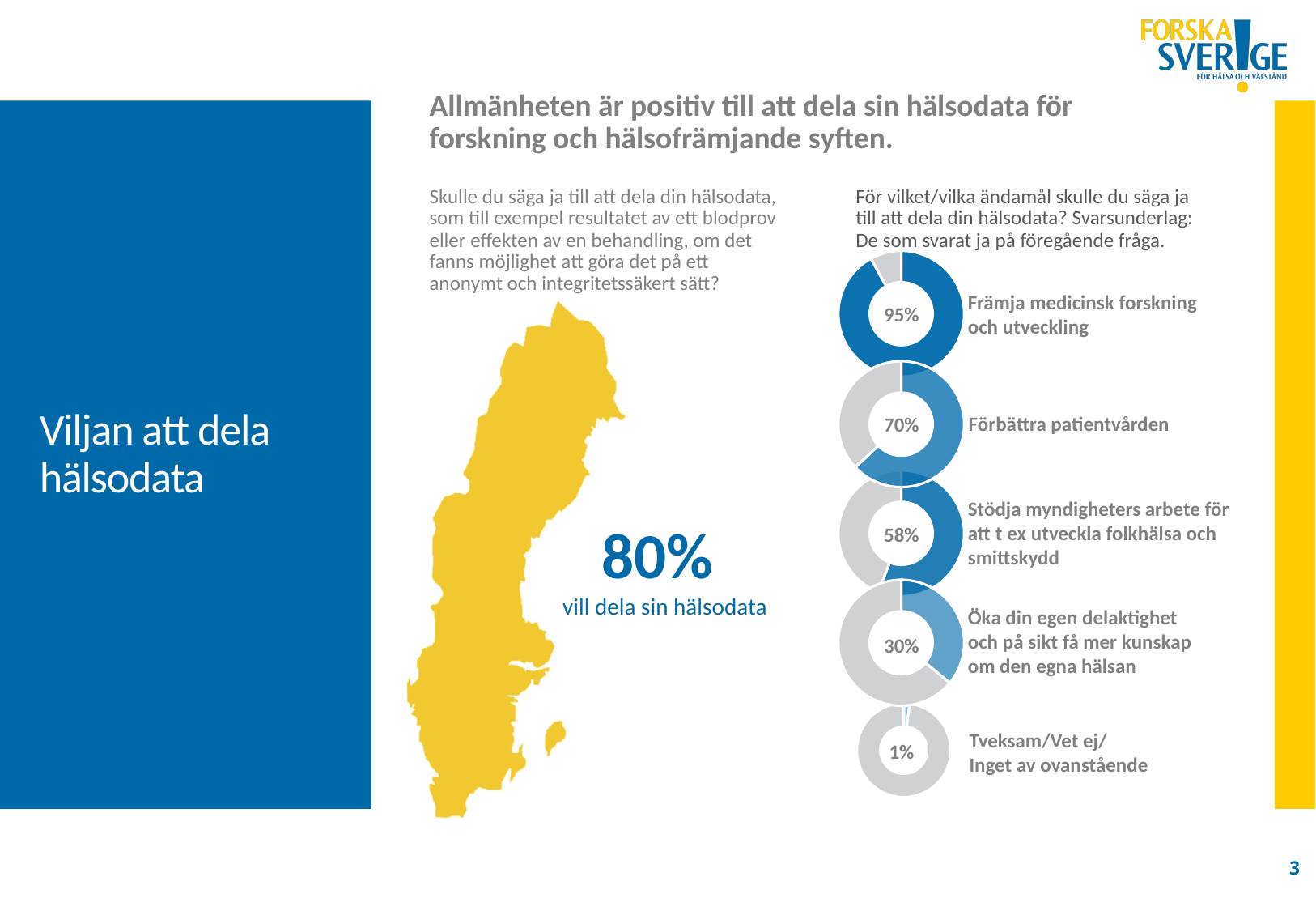
In the donut charts on the right, what percentage is shown for "Tveksam/Vet ej/Inget av ovanstående"? 1% According to the large figure next to the map of Sweden, what percentage want to share their health data? 80% In the donut charts on the right, what percentage is shown for "Förbättra patientvården"? 70% In the donut charts on the right, what percentage is shown for "Främja medicinsk forskning och utveckling"? 95% How many donut charts are shown on the right side of the slide? 5 In the donut charts on the right, what is the difference in percentage points between "Främja medicinsk forskning och utveckling" and "Förbättra patientvården"? 25 percentage points Among the donut charts on the right, which purpose has the highest percentage? Främja medicinsk forskning och utveckling What kind of chart is used to show the percentages on the right side of the slide? Donut chart In the donut charts on the right, what percentage is shown for "Stödja myndigheters arbete för att t ex utveckla folkhälsa och smittskydd"? 58% Among the donut charts on the right, which category has the lowest percentage? Tveksam/Vet ej/Inget av ovanstående In the donut charts on the right, what percentage is shown for "Öka din egen delaktighet och på sikt få mer kunskap om den egna hälsan"? 30% In the donut charts on the right, which has the larger percentage: "Förbättra patientvården" or "Öka din egen delaktighet och på sikt få mer kunskap om den egna hälsan"? Förbättra patientvården